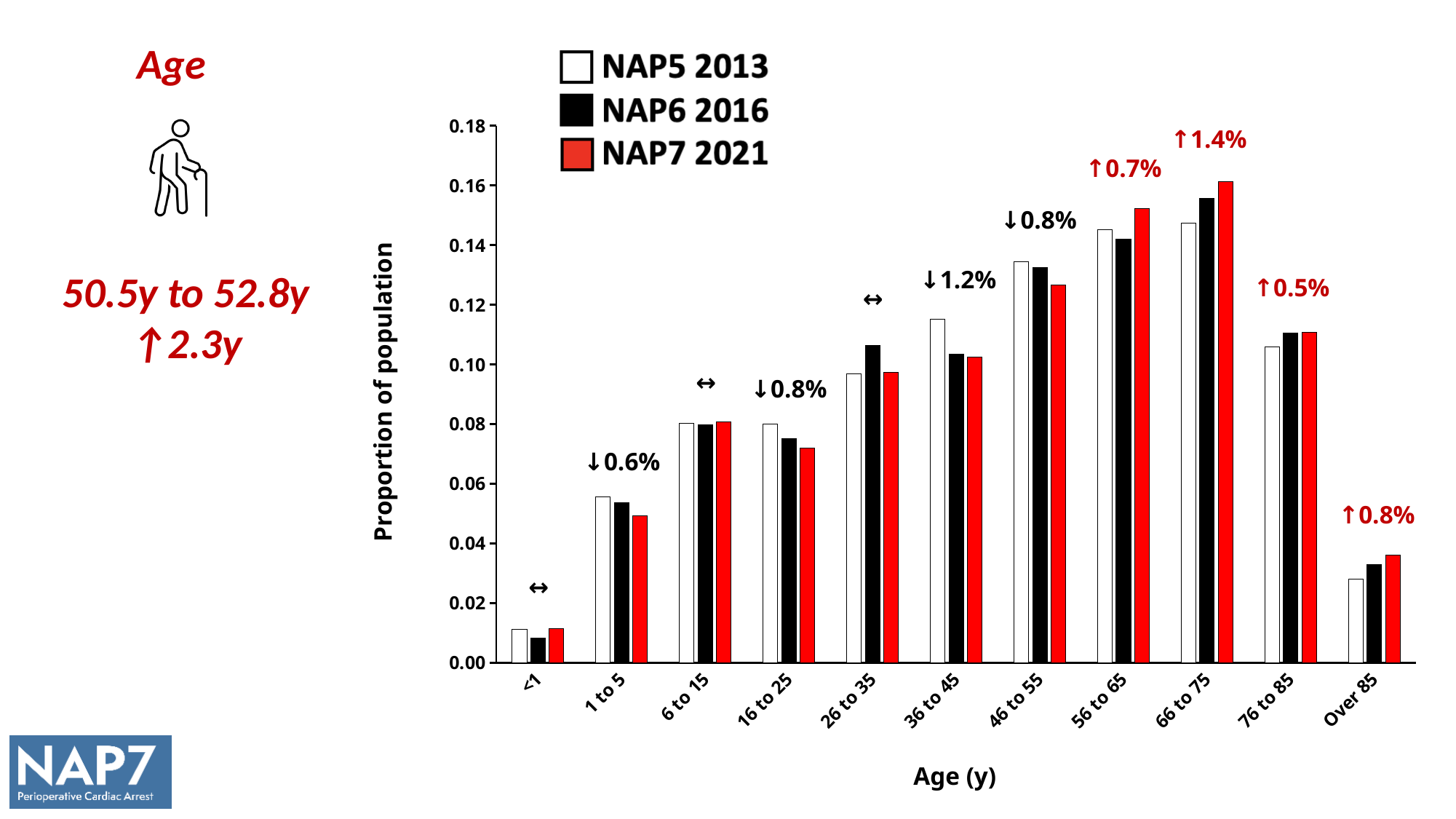
Which series is shown in red in the legend? NAP7 2021 For the 36 to 45 age group, which is larger: the NAP5 2013 bar or the NAP7 2021 bar? NAP5 2013 For the 56 to 65 age group, which is larger: the NAP5 2013 bar or the NAP7 2021 bar? NAP7 2021 Is the NAP7 2021 value for 66 to 75 greater or less than 0.14? greater Which age category has the highest NAP7 2021 bar? 66 to 75 What change annotation is printed above the 66 to 75 age group? ↑1.4% How many series does the legend list? 3 Is the NAP6 2016 value for 26 to 35 greater or less than 0.10? greater Which age category has the lowest NAP7 2021 bar? <1 What kind of chart is shown on the slide? Bar chart How many age categories are shown on the x axis? 11 Is the NAP7 2021 value for Over 85 greater or less than 0.04? less